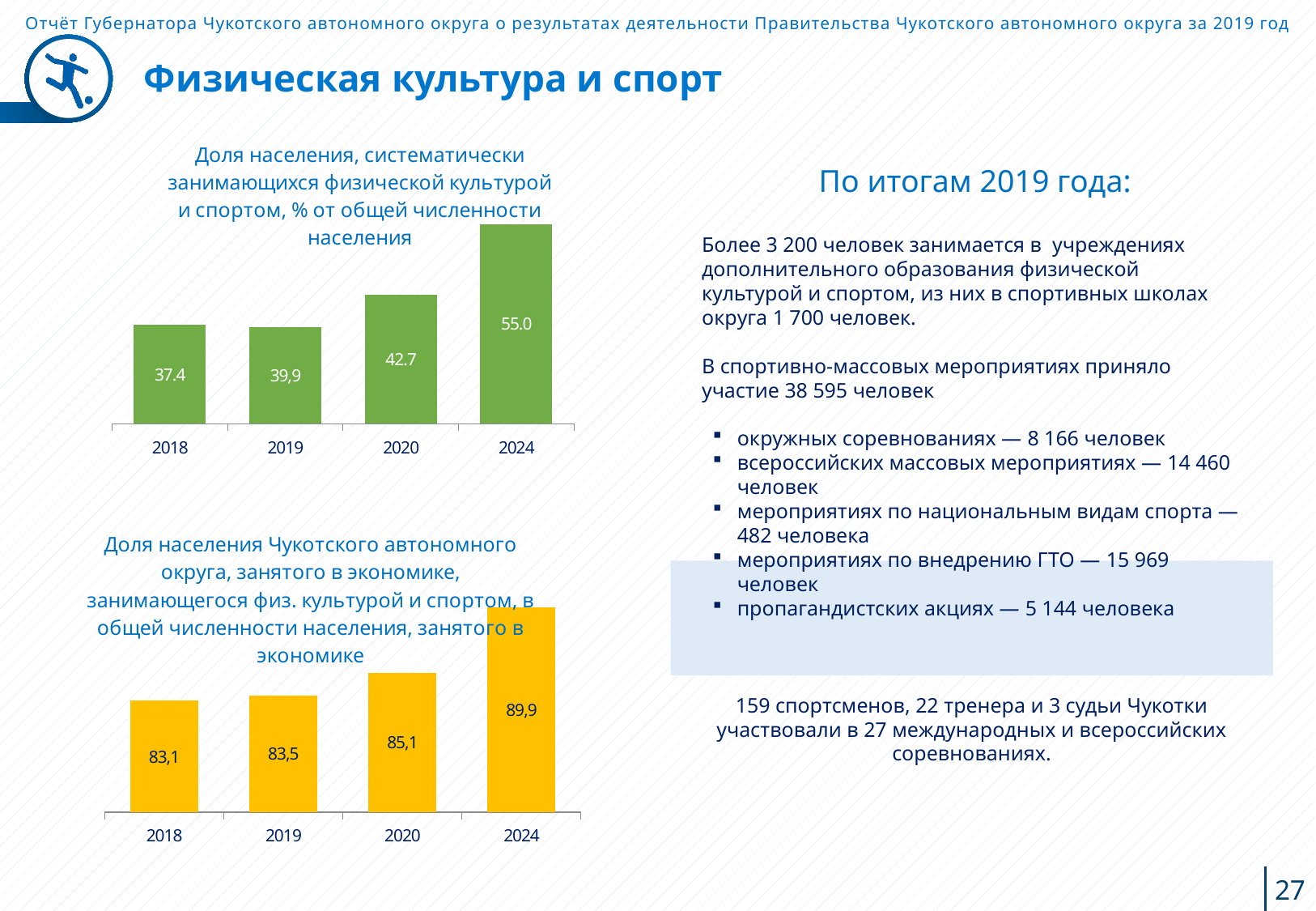
In the bottom chart, do the values rise or fall from 2018 to 2024? Rise In the top chart, which is larger: the value for 2019 or the value for 2020? 2020 In the top chart (share of population systematically engaged in physical culture and sport), what is the value for 2024? 55.0 In the bottom chart (share of employed population engaged in physical culture and sport), what is the value for 2019? 83,5 How many bars are shown in the bottom chart? 4 In the bottom chart, which year has the lowest value? 2018 What type of chart is the top chart on the slide? Bar chart In the bottom chart, what is the difference between the 2024 value and the 2018 value? 6,8 In the top chart, which year has the highest value? 2024 In the top chart, what is the difference between the 2024 value and the 2018 value? 17.6 In the bottom chart (share of employed population engaged in physical culture and sport), what is the value for 2020? 85,1 In the top chart (share of population systematically engaged in physical culture and sport), what is the value for 2018? 37.4